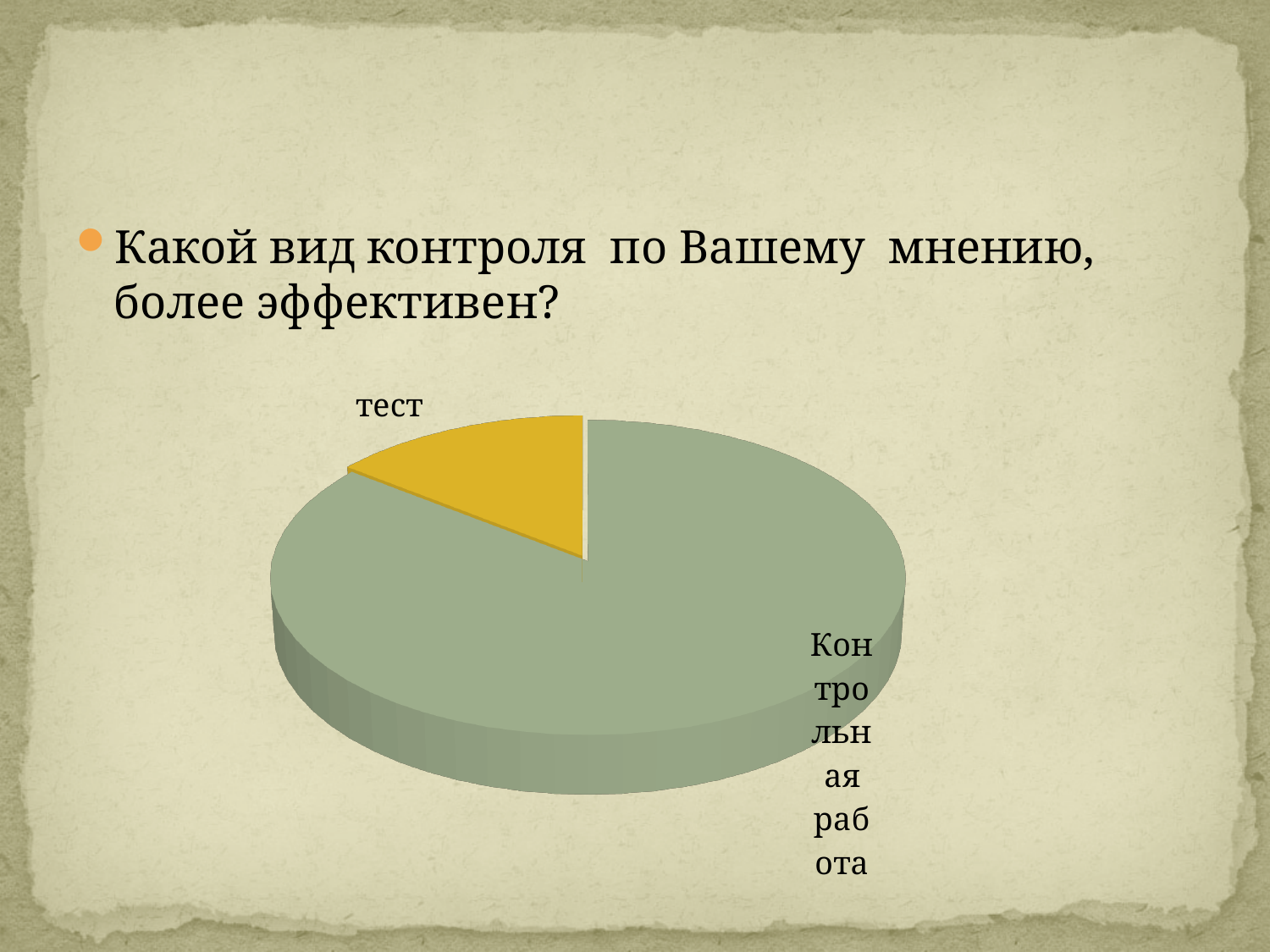
What colour is the "тест" slice of the pie chart? yellow How many slices does the pie chart have? 2 What kind of chart is shown on the slide? pie chart Which slice of the pie chart is the smallest? тест Is the share of the "Контрольная работа" slice greater or less than 50%? greater Which slice is larger, "тест" or "Контрольная работа"? Контрольная работа Is the share of the "тест" slice greater or less than 50%? less What question does the slide pose above the pie chart? Какой вид контроля по Вашему мнению, более эффективен? Which slice of the pie chart is the largest? Контрольная работа